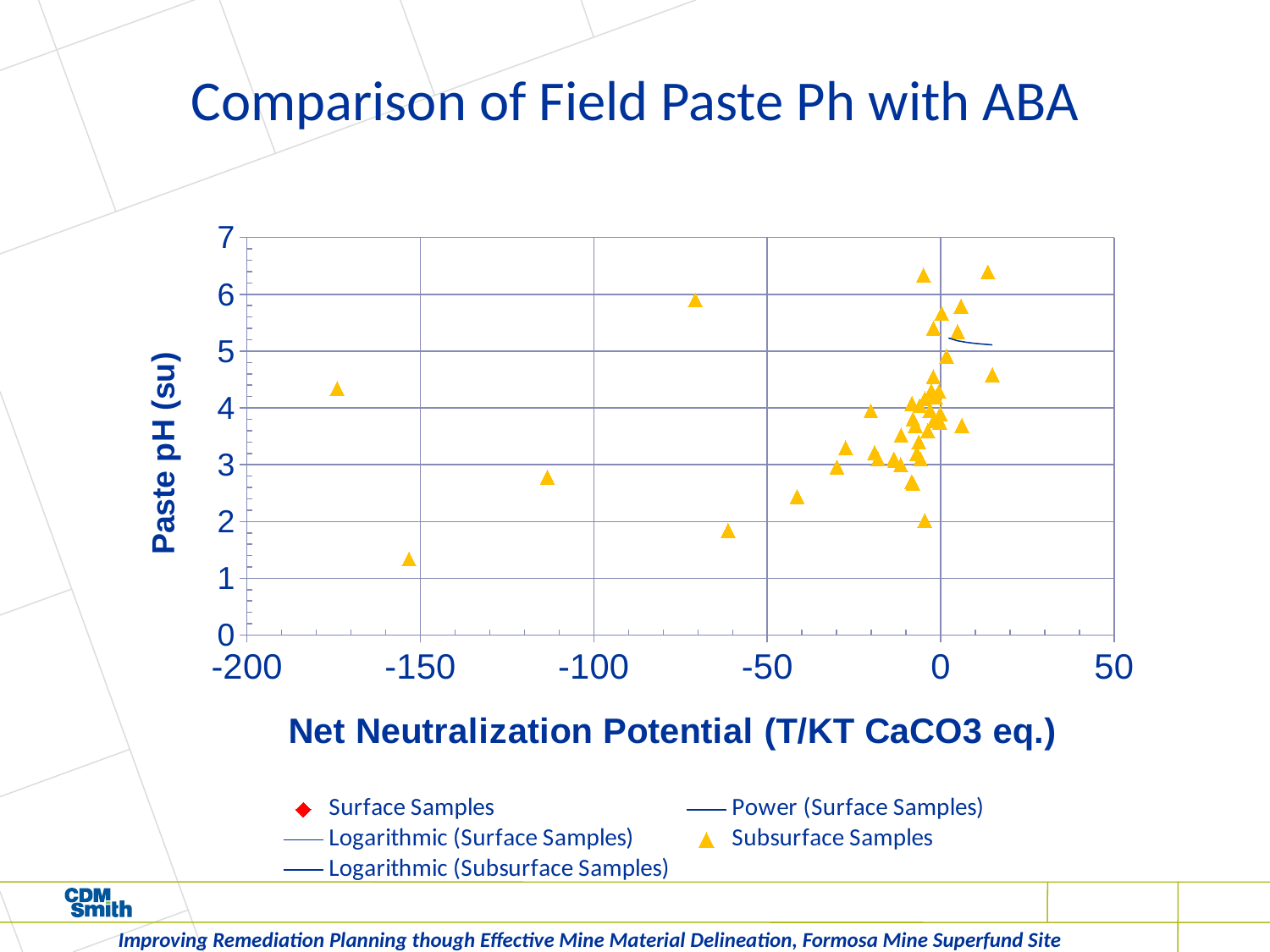
What kind of chart is shown on the slide? Scatter chart What is the title of the chart? Comparison of Field Paste Ph with ABA How many entries does the chart legend list? 5 What is the label of the vertical axis? Paste pH (su) Is the lowest Paste pH value plotted for the Subsurface Samples greater or less than 2? less Do the Paste pH values of the Subsurface Samples generally rise or fall as Net Neutralization Potential increases along the x axis? rise Is the Net Neutralization Potential of the leftmost Subsurface Samples point greater or less than -150? less Which series' markers are plotted on the chart: Surface Samples or Subsurface Samples? Subsurface Samples Is the highest Paste pH value plotted for the Subsurface Samples greater or less than 6? greater